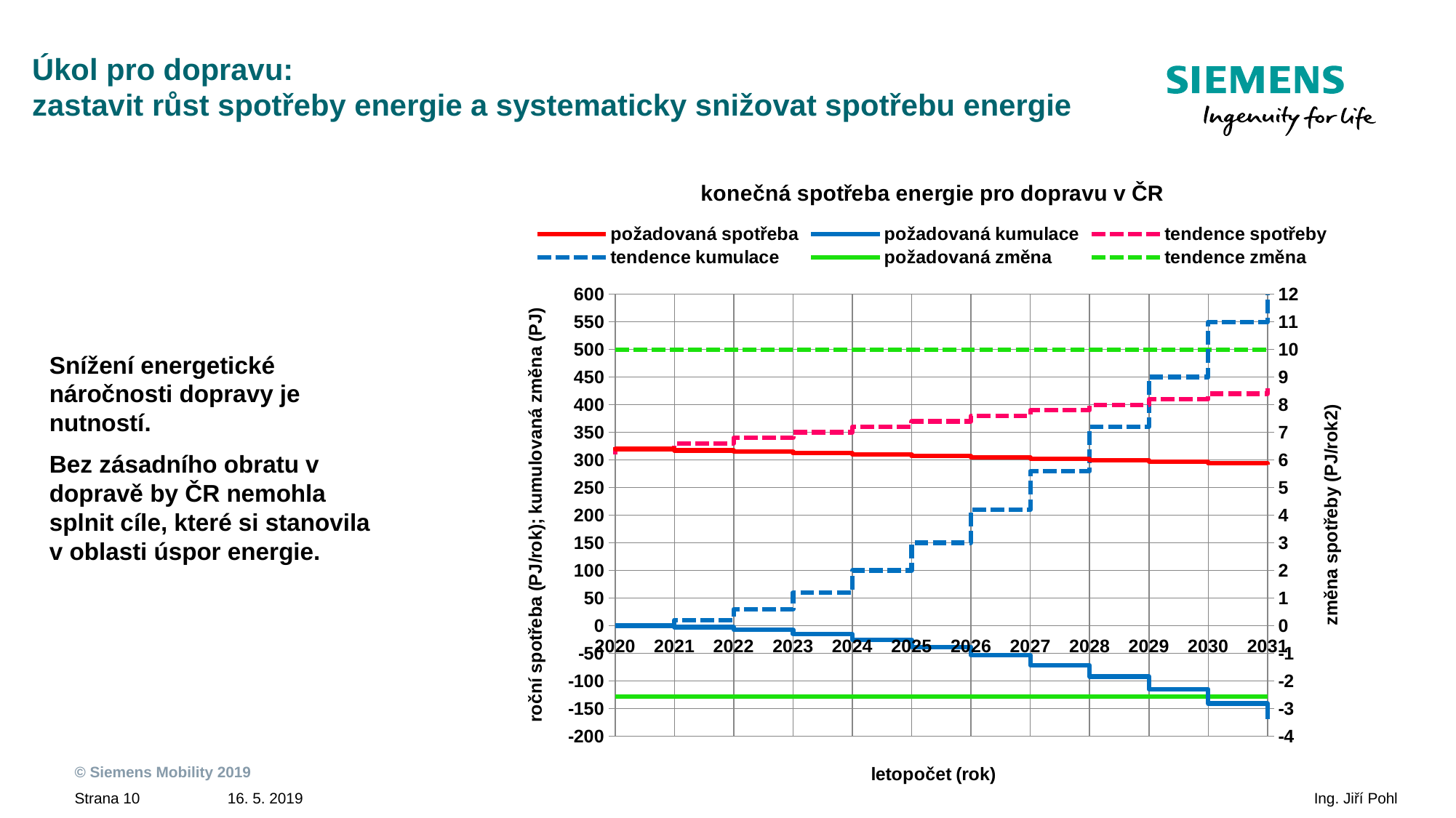
Is the value of 'požadovaná kumulace' in 2031 greater or less than -100 on the left axis? less What is the title of the chart? konečná spotřeba energie pro dopravu v ČR Which series reaches the highest value on the chart in 2031? tendence kumulace In 2031, which is larger: 'tendence spotřeby' or 'požadovaná spotřeba'? tendence spotřeby How many year labels are shown on the x axis of the chart? 12 How many series does the chart legend list? 6 What kind of chart is shown on the slide? line chart What is the label of the x axis of the chart? letopočet (rok) Does the 'tendence kumulace' series rise or fall from 2020 to 2031? rise Does the 'požadovaná spotřeba' series rise or fall from 2020 to 2031? fall Is the value of 'tendence spotřeby' in 2031 greater or less than 400 on the left axis? greater Is the value of 'tendence kumulace' in 2031 greater or less than 500 on the left axis? greater